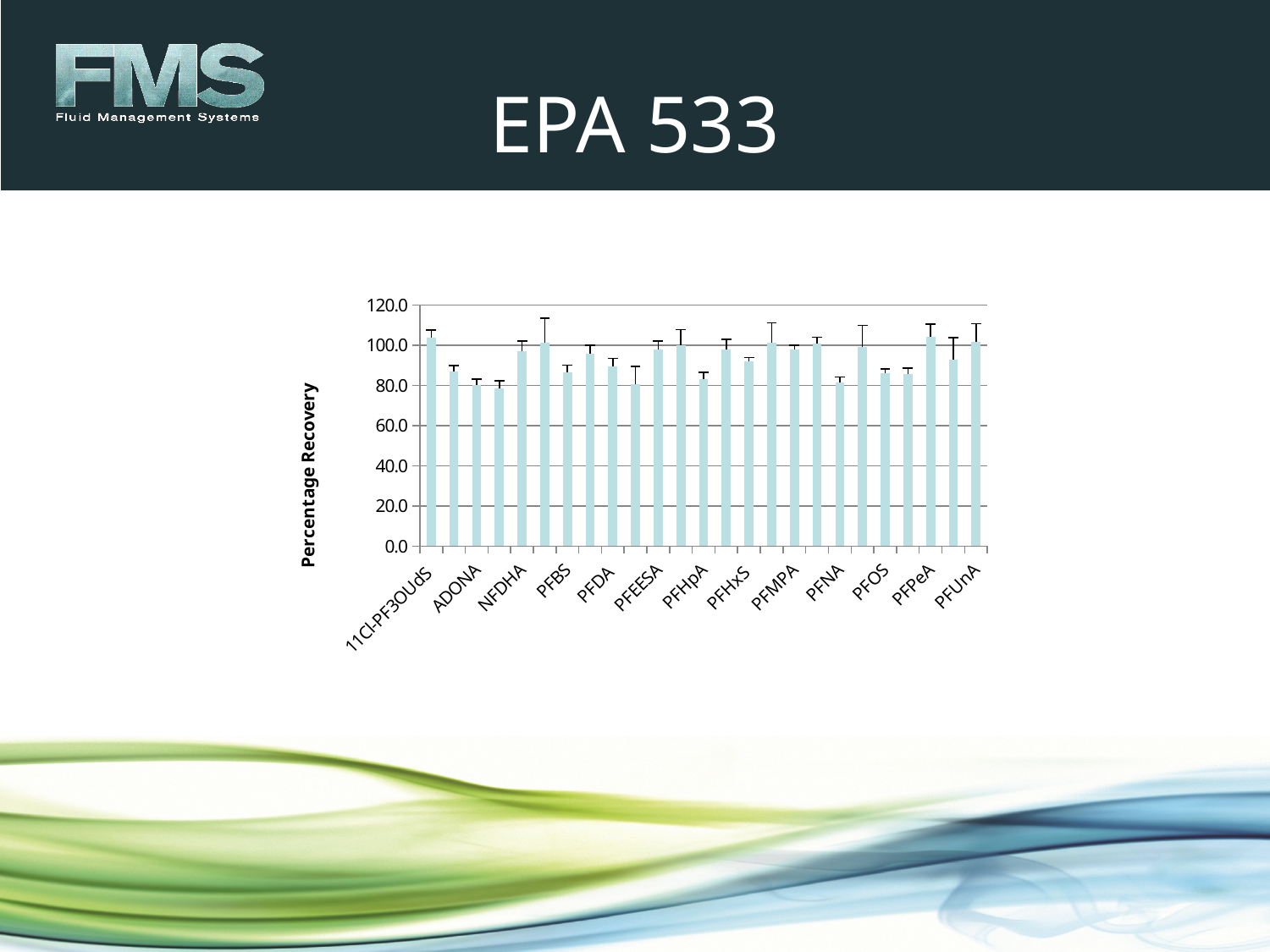
What is the highest tick value shown on the vertical axis? 120.0 Is the value for PFUnA greater or less than 60? greater What is the label of the vertical axis? Percentage Recovery Do any of the bars in the chart fall below 60 on the vertical axis? No Is the value for ADONA greater or less than 100? less How many bars are plotted in the chart? 25 What kind of chart is shown on the slide? bar chart